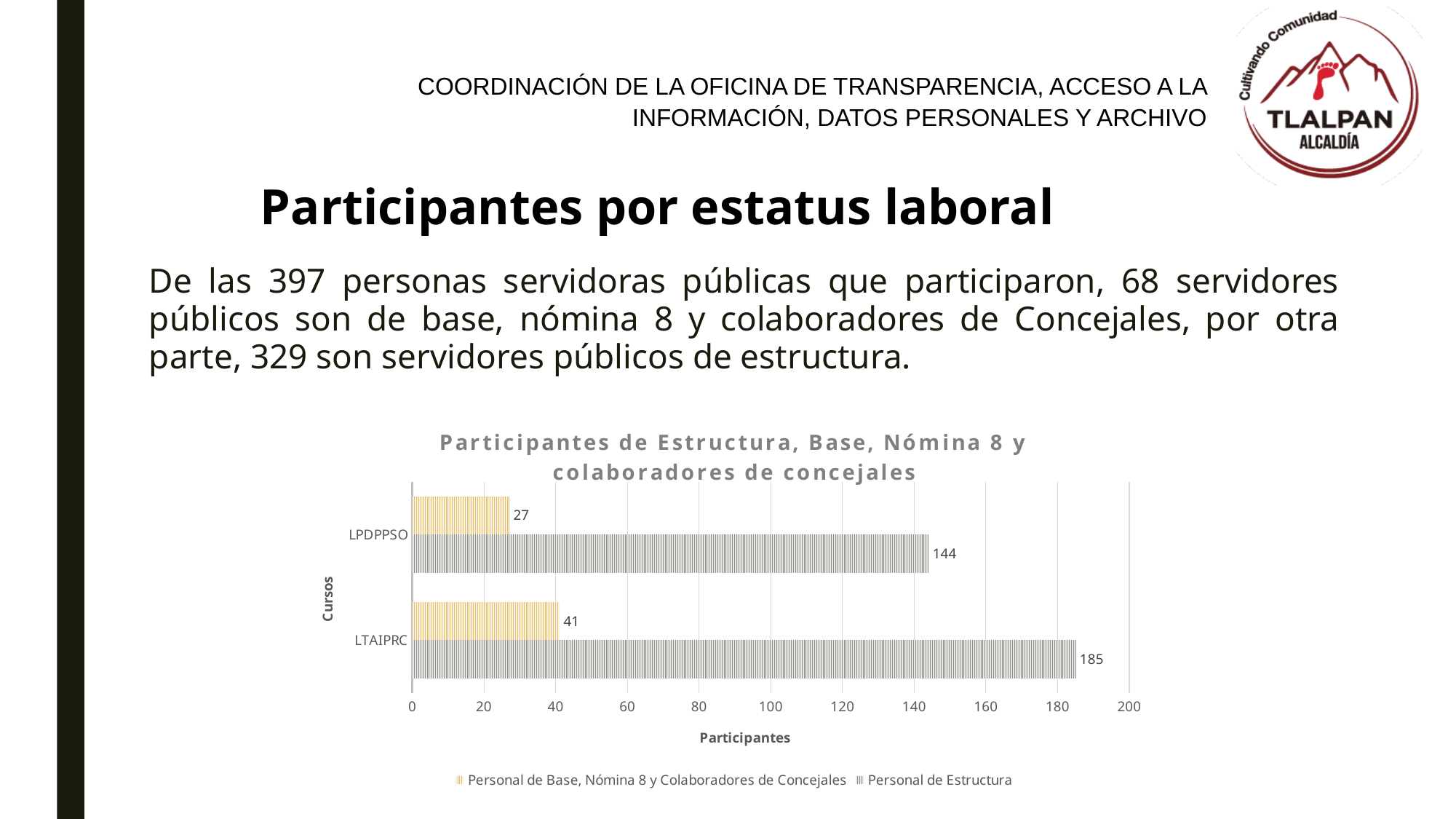
Which category has the lowest value for Personal de Base, Nómina 8 y Colaboradores de Concejales? LPDPPSO What is the value for Personal de Estructura in the LTAIPRC category? 185 What is the difference between the Personal de Estructura values for LTAIPRC and LPDPPSO? 41 What is the value for Personal de Base, Nómina 8 y Colaboradores de Concejales in the LPDPPSO category? 27 Which is larger: Personal de Base, Nómina 8 y Colaboradores de Concejales for LTAIPRC or for LPDPPSO? LTAIPRC What is the title of the chart? Participantes de Estructura, Base, Nómina 8 y colaboradores de concejales How many categories (cursos) are shown on the chart? 2 What is the value for Personal de Base, Nómina 8 y Colaboradores de Concejales in the LTAIPRC category? 41 Which category has the highest value for Personal de Estructura? LTAIPRC What kind of chart is shown on the slide? Bar chart How many series does the legend list? 2 What is the value for Personal de Estructura in the LPDPPSO category? 144